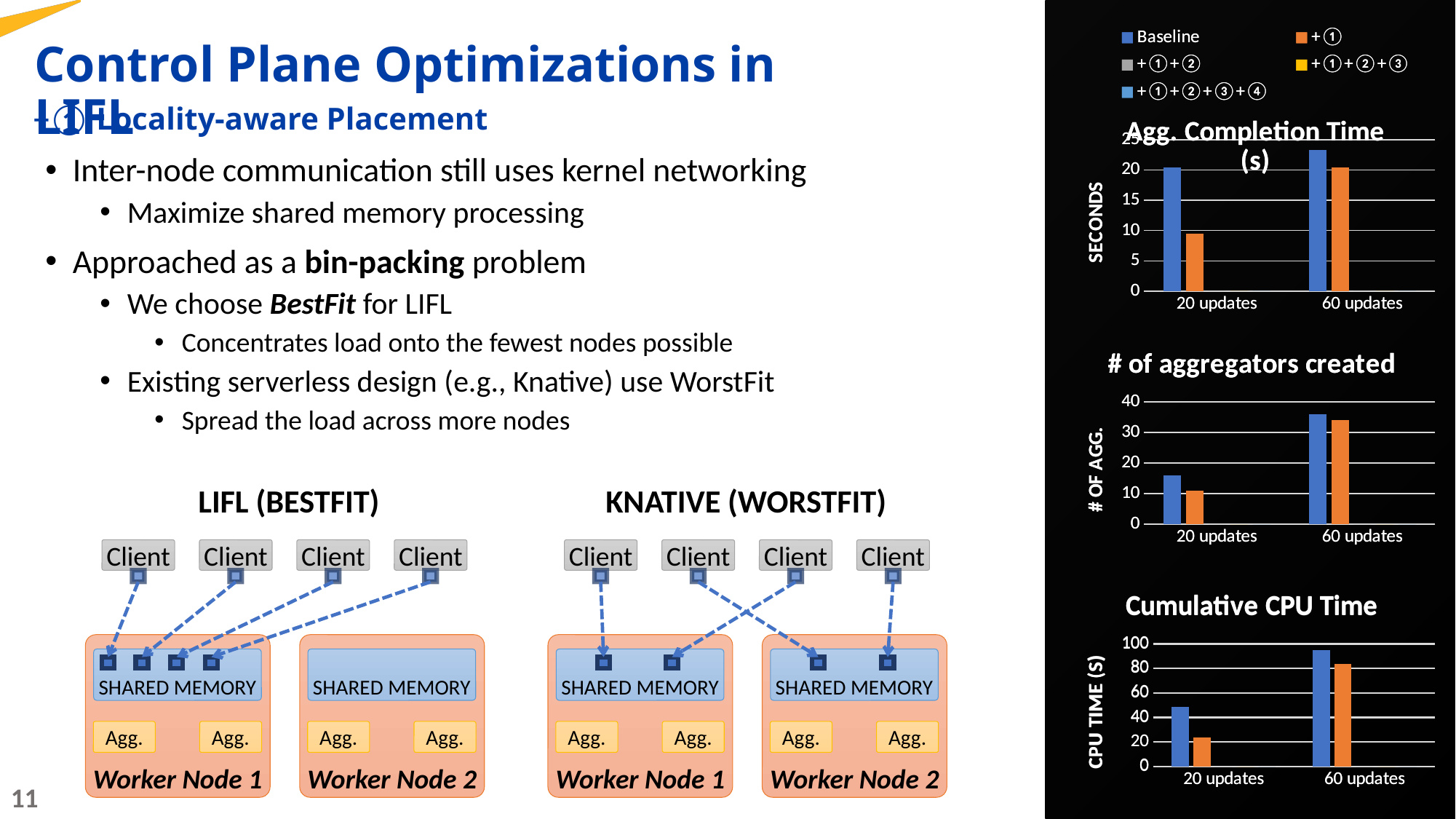
In the "Cumulative CPU Time" chart, which category has the highest Baseline value? 60 updates In the "Cumulative CPU Time" chart, is the +① value for 20 updates greater or less than 40? less In the "Cumulative CPU Time" chart, does the Baseline value rise or fall from 20 updates to 60 updates? rise In the "Cumulative CPU Time" chart, is the Baseline value for 60 updates greater or less than 80? greater In the "# of aggregators created" chart, is the Baseline value for 60 updates greater or less than 30? greater In the "Agg. Completion Time (s)" chart, which is larger for 20 updates: Baseline or +①? Baseline What kind of chart is the "Agg. Completion Time (s)" chart? bar chart How many categories are shown on the x axis of the "# of aggregators created" chart? 2 What is the y-axis label of the "Cumulative CPU Time" chart? CPU TIME (S)